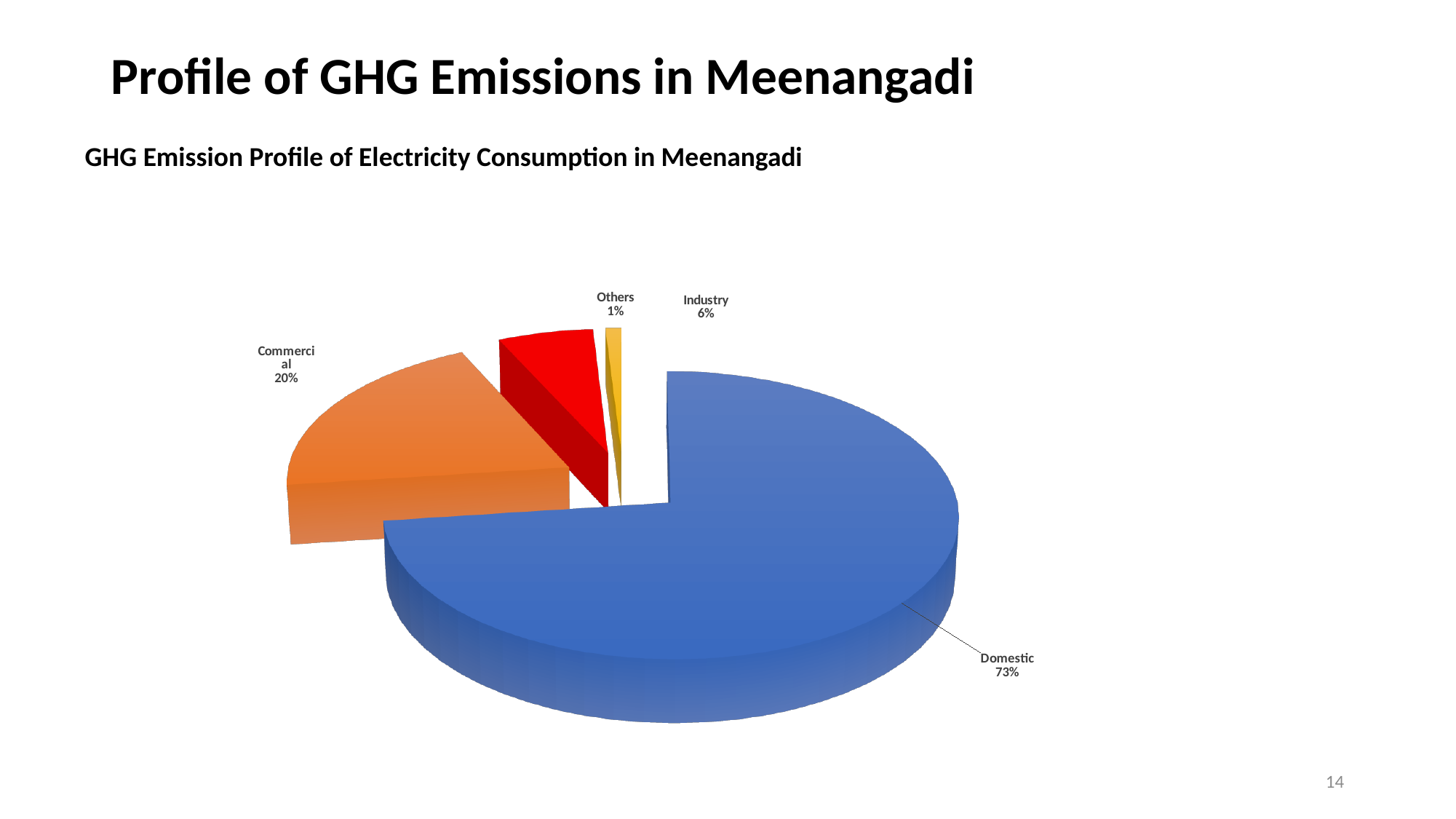
What share of the pie does Industry account for? 6% What share of the pie does Commercial account for? 20% Which has a larger share, Commercial or Industry? Commercial What kind of chart is shown on the slide? Pie chart Which category has the largest share of the pie? Domestic How many categories are shown in the pie chart? 4 What share of the pie does Domestic account for? 73% What is the difference in percentage points between the Industry and Others shares? 5 What is the title of the chart? GHG Emission Profile of Electricity Consumption in Meenangadi Which category has the smallest share of the pie? Others What is the difference in percentage points between the Domestic and Commercial shares? 53